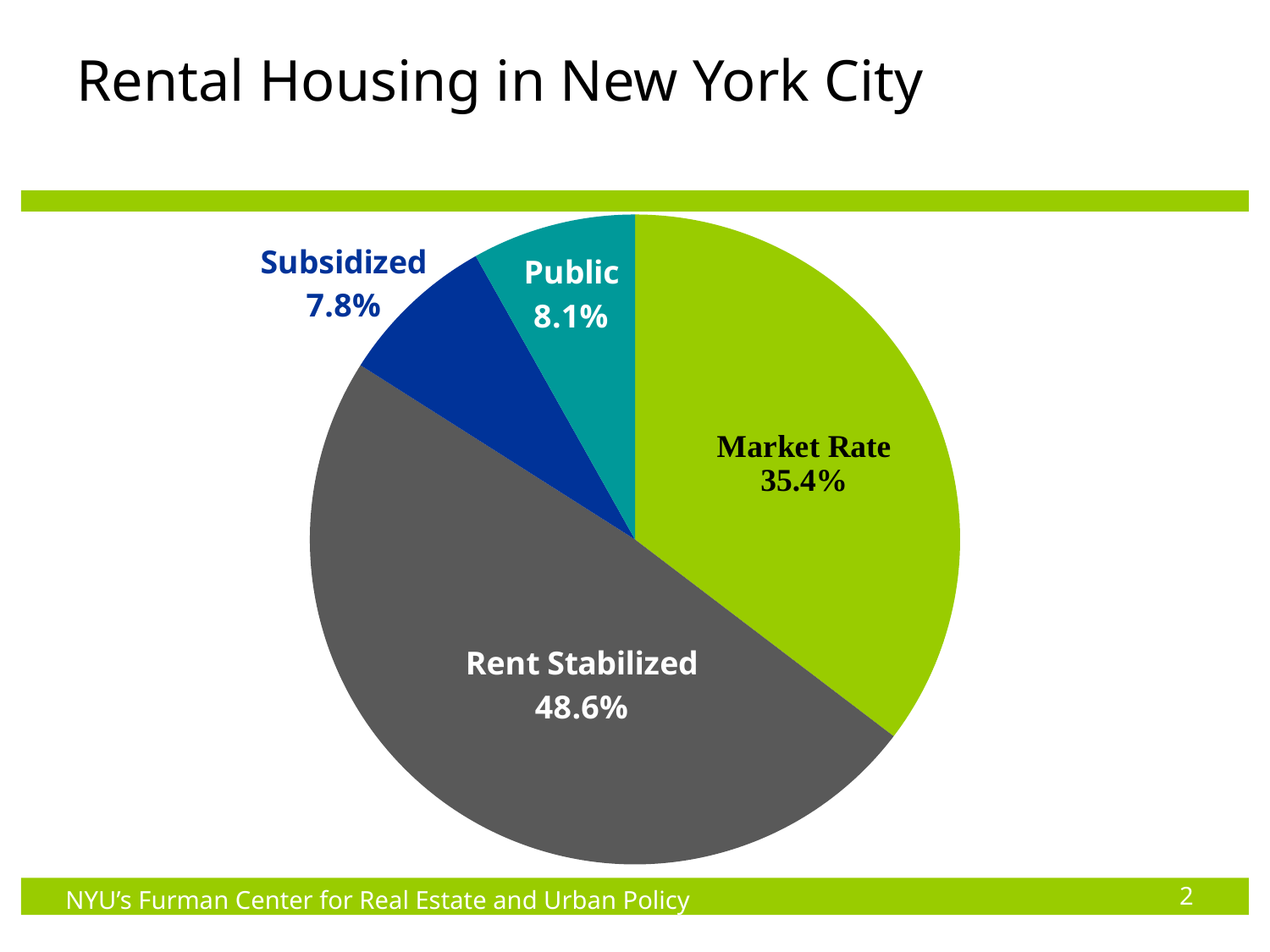
What kind of chart is shown on the slide? Pie chart What is the difference in percentage points between Rent Stabilized and Market Rate? 13.2 How many categories are shown in the pie chart? 4 What share of rental housing is Rent Stabilized? 48.6% Which category has the smallest share of the pie? Subsidized What share of rental housing is Subsidized? 7.8% Which category has the largest share of the pie? Rent Stabilized What is the title of the slide containing the chart? Rental Housing in New York City Which is larger, the Public share or the Subsidized share? Public What is the combined share of Public and Subsidized housing? 15.9% What share of rental housing is Public? 8.1% What share of rental housing is Market Rate? 35.4%